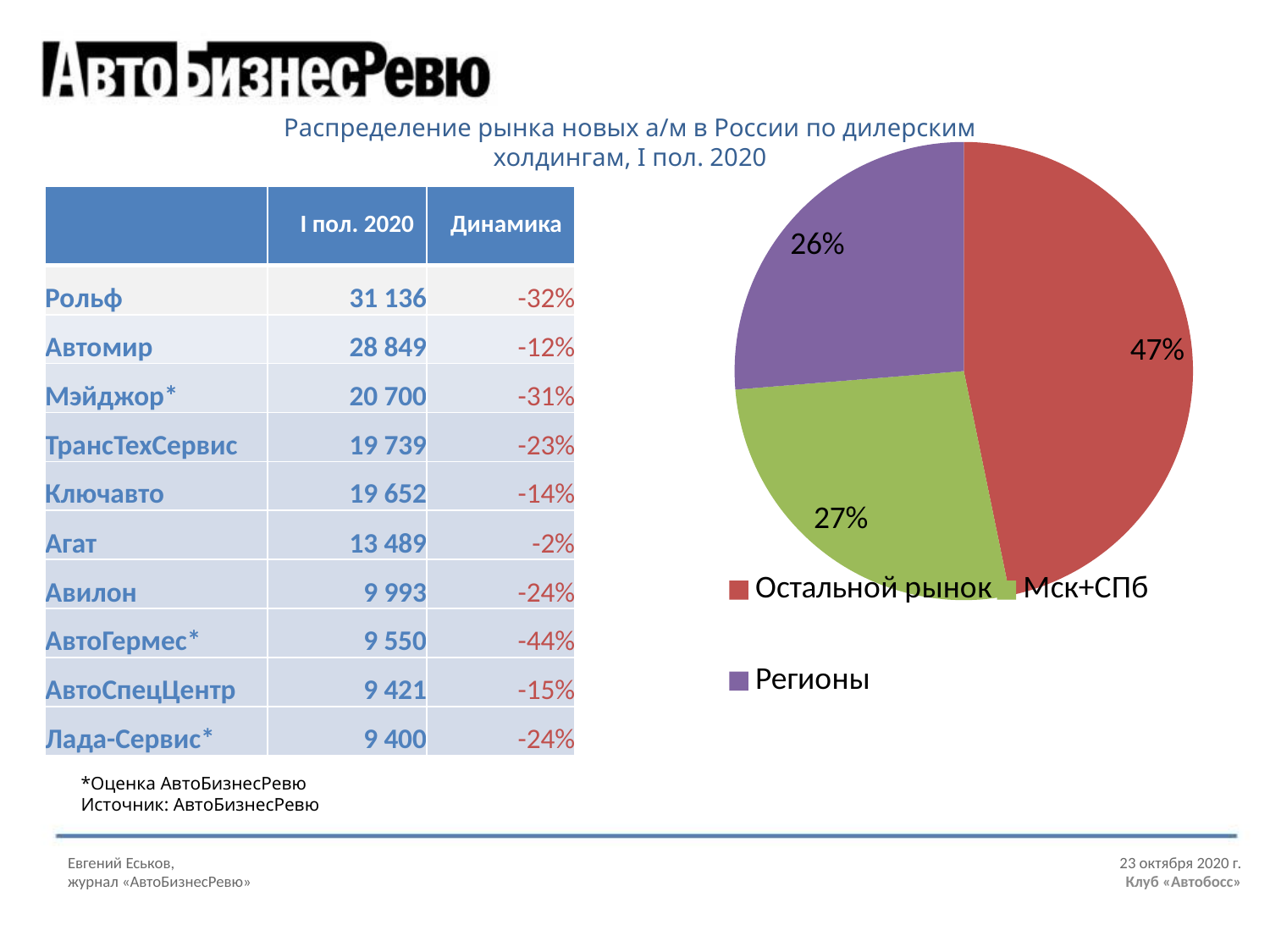
What colour is the "Регионы" slice in the pie chart? Purple What share of the pie chart does "Мск+СПб" have? 27% Which slice of the pie chart is the largest? Остальной рынок How many entries does the pie chart legend list? 3 What is the difference in percentage points between the "Остальной рынок" slice and the "Мск+СПб" slice? 20 percentage points What share of the pie chart does "Регионы" have? 26% What share of the pie chart does "Остальной рынок" have? 47% Which slice of the pie chart is the smallest? Регионы Which is larger in the pie chart: "Остальной рынок" or "Регионы"? Остальной рынок What kind of chart is shown on the slide? Pie chart How many slices does the pie chart have? 3